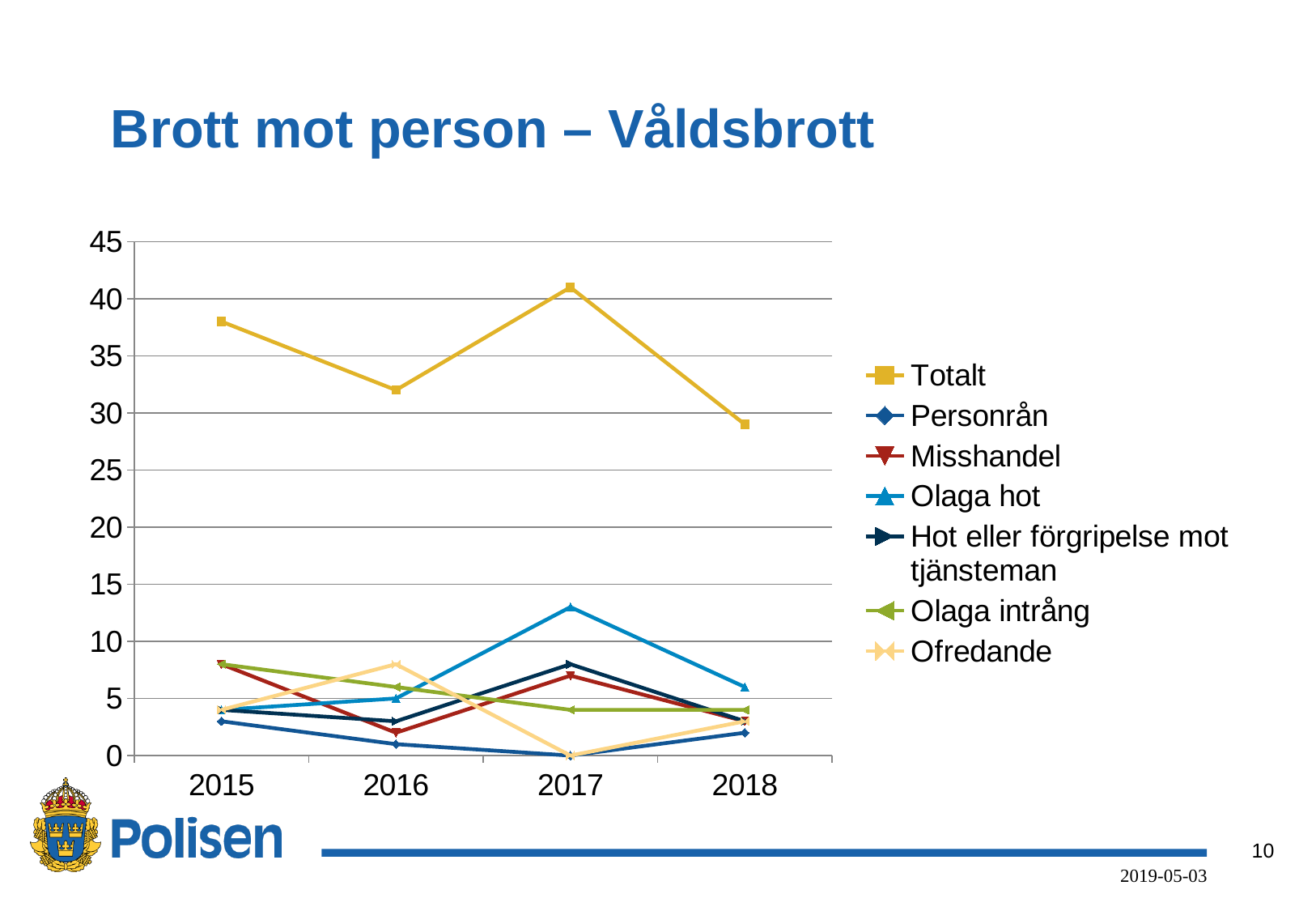
In which year is the Totalt series highest? 2017 How many years are shown on the x axis? 4 Does the Totalt series rise or fall from 2017 to 2018? fall Is the value for Totalt in 2017 greater or less than 40? greater How many series does the legend list? 7 Which is larger in 2017, Olaga hot or Misshandel? Olaga hot What kind of chart is shown on the slide? line chart In which year is the Totalt series lowest? 2018 Is the value for Totalt in 2018 greater or less than 30? less What is the value for Olaga hot in 2016? 5 Is the value for Olaga hot in 2017 greater or less than 10? greater What is the value for Personrån in 2017? 0